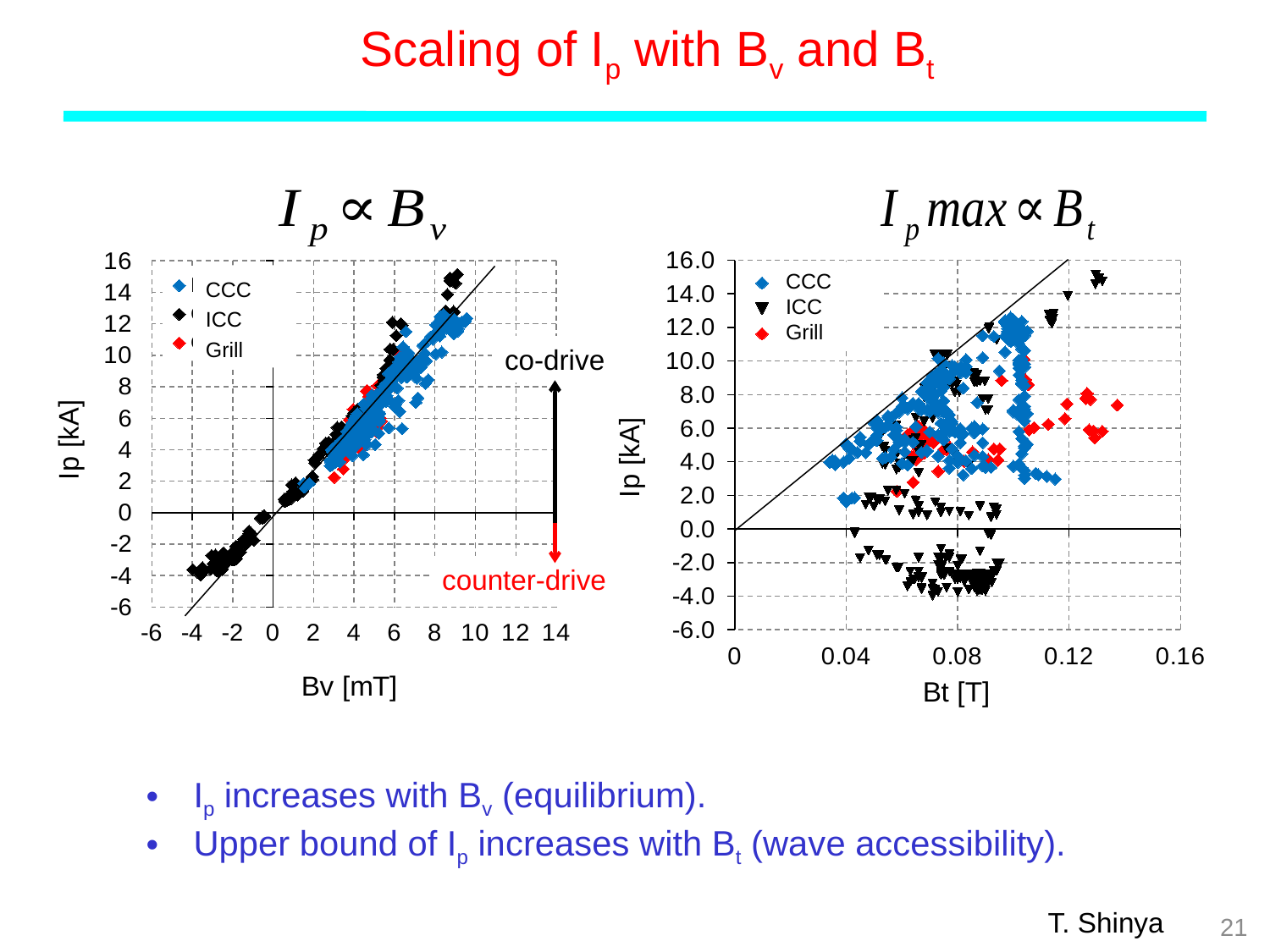
What is the x-axis label of the right chart (Ip max ∝ Bt)? Bt [T] In the right chart (Ip max ∝ Bt), does the upper bound of Ip rise or fall as Bt increases? rise In the left chart (Ip ∝ Bv), what are the three series named in the legend? CCC, ICC, Grill In the right chart (Ip max ∝ Bt), is the highest ICC value greater or less than 14.0? greater In the left chart (Ip ∝ Bv), does Ip rise or fall as Bv increases? rise In the right chart (Ip max ∝ Bt), is the highest Grill value greater or less than 12.0? less In the left chart (Ip ∝ Bv), is the highest ICC value greater or less than 14? greater How many series does the legend of the left chart (Ip ∝ Bv) list? 3 How many series does the legend of the right chart (Ip max ∝ Bt) list? 3 What kind of chart is the right chart titled "Ip max ∝ Bt"? scatter chart What kind of chart is the left chart titled "Ip ∝ Bv"? scatter chart